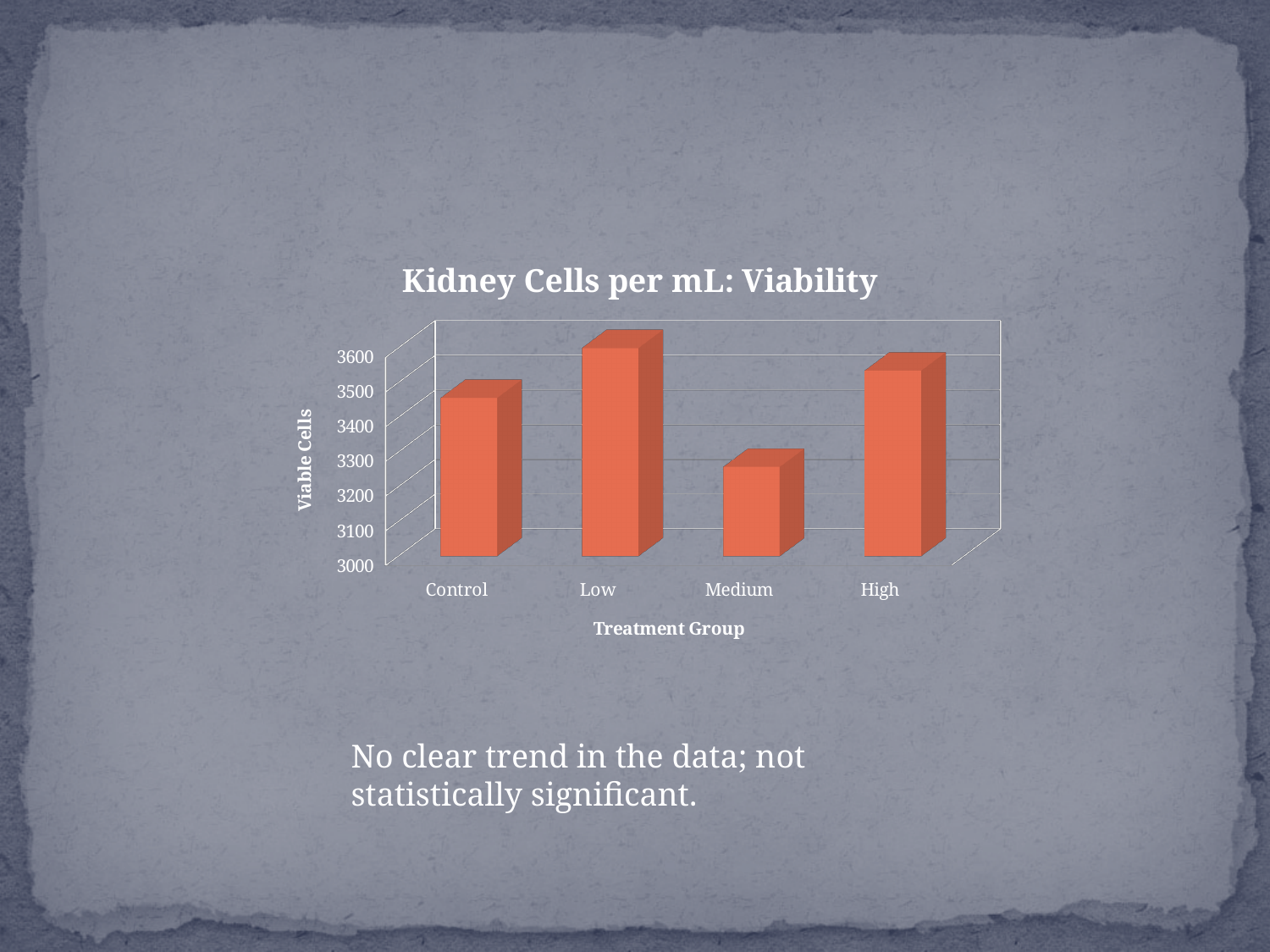
Is the value for High greater or less than 3400? greater What kind of chart is shown on the slide? bar chart Is the value for Medium greater or less than 3400? less Which has more viable cells, Low or Medium? Low How many treatment groups are plotted on the chart? 4 Is the value for Control greater or less than 3400? greater What is the label on the horizontal axis of the chart? Treatment Group What is the title of the chart? Kidney Cells per mL: Viability Which treatment group has the lowest number of viable cells? Medium Which has more viable cells, Control or Medium? Control Which treatment group has the highest number of viable cells? Low